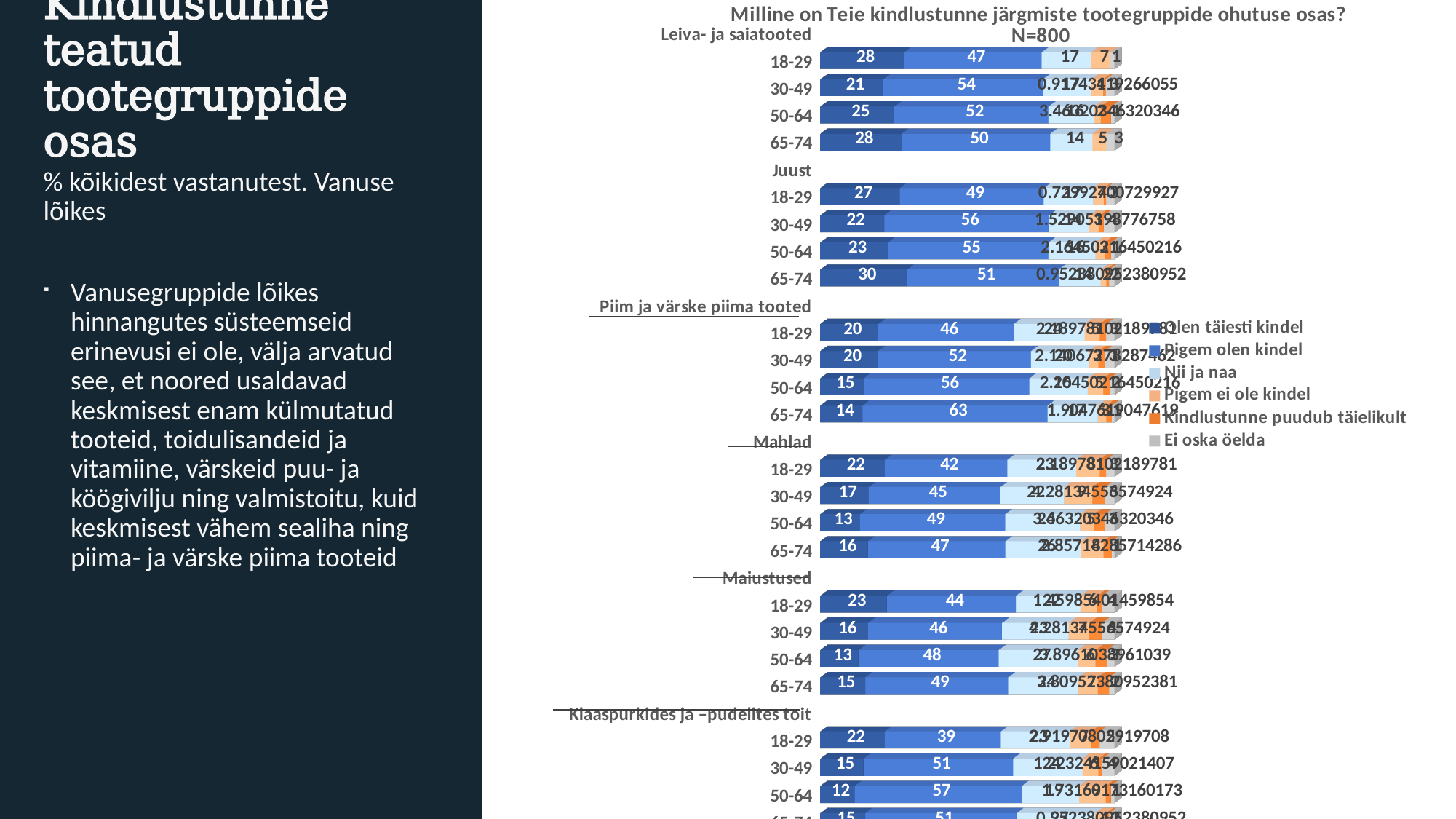
How many series does the chart legend list? 6 For Juust, what is the 'Olen täiesti kindel' value for the 65-74 age group? 30 For Piim ja värske piima tooted, what is the 'Pigem olen kindel' value for the 65-74 age group? 63 For Maiustused, which age group has the larger 'Olen täiesti kindel' value: 18-29 or 65-74? 18-29 What is the sample size (N) shown under the chart title? N=800 Within Juust, which age group has the highest 'Olen täiesti kindel' value? 65-74 What kind of chart is shown on the slide? stacked bar chart For Leiva- ja saiatooted, what is the 'Olen täiesti kindel' value for the 18-29 age group? 28 For Klaaspurkides ja -pudelites toit, what is the 'Pigem olen kindel' value for the 50-64 age group? 57 For Leiva- ja saiatooted, what is the difference between the 'Pigem olen kindel' values of the 30-49 and 18-29 age groups? 7 Within Mahlad, which age group has the lowest 'Olen täiesti kindel' value? 50-64 For Leiva- ja saiatooted, what is the 'Nii ja naa' value for the 65-74 age group? 14